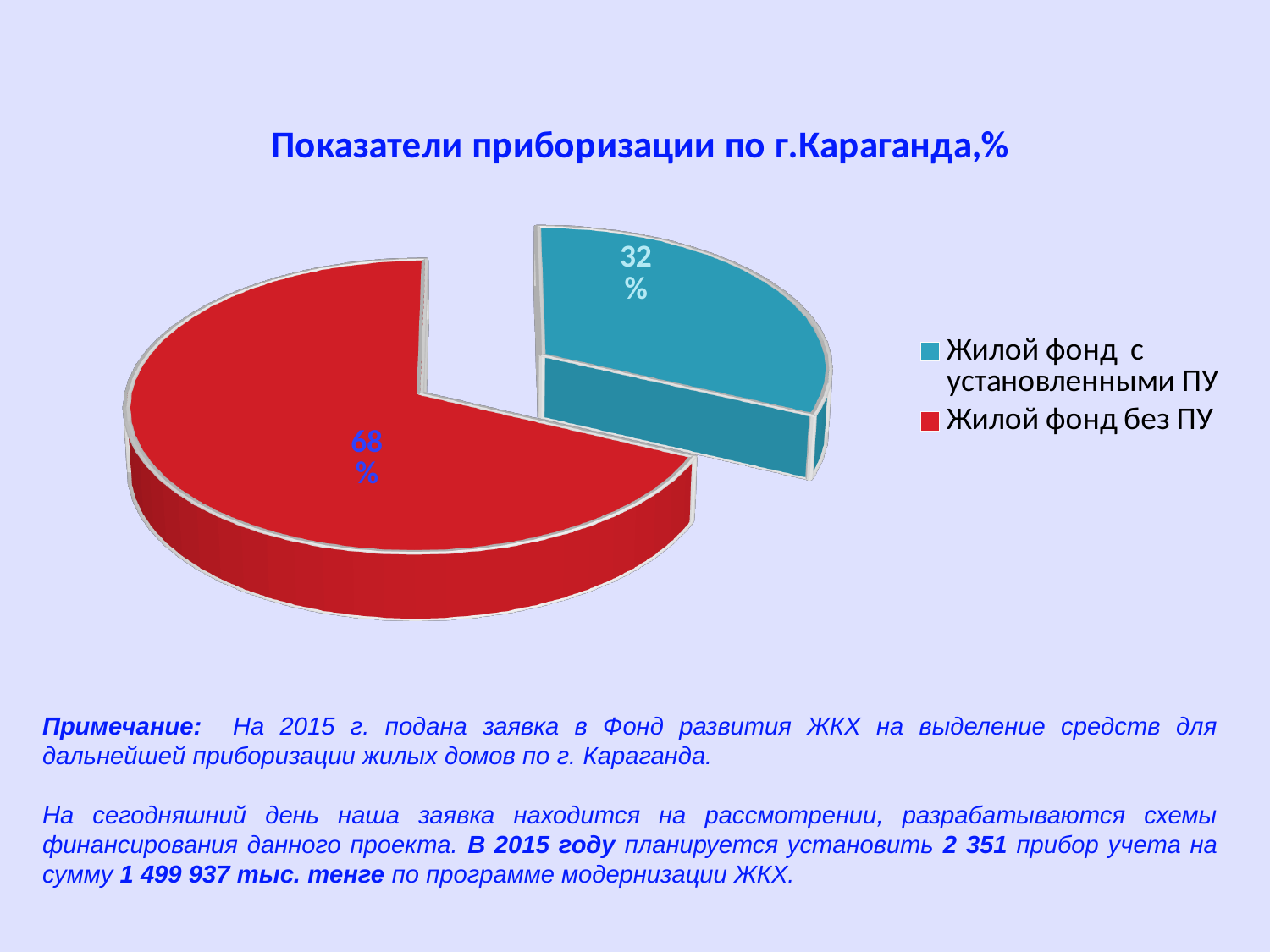
What colour is the slice for "Жилой фонд без ПУ"? red What type of chart is shown on the slide? pie chart What is the difference between the share of "Жилой фонд без ПУ" and "Жилой фонд с установленными ПУ"? 36% Which category has the largest share of the pie? Жилой фонд без ПУ Which is larger: the share of "Жилой фонд с установленными ПУ" or "Жилой фонд без ПУ"? Жилой фонд без ПУ How many slices does the pie chart have? 2 What is the title of the chart? Показатели приборизации по г.Караганда,% How many entries does the legend list? 2 What is the value for "Жилой фонд с установленными ПУ"? 32% What is the value for "Жилой фонд без ПУ"? 68% What share of the pie does "Жилой фонд с установленными ПУ" represent? 32% Which category has the smallest share of the pie? Жилой фонд с установленными ПУ